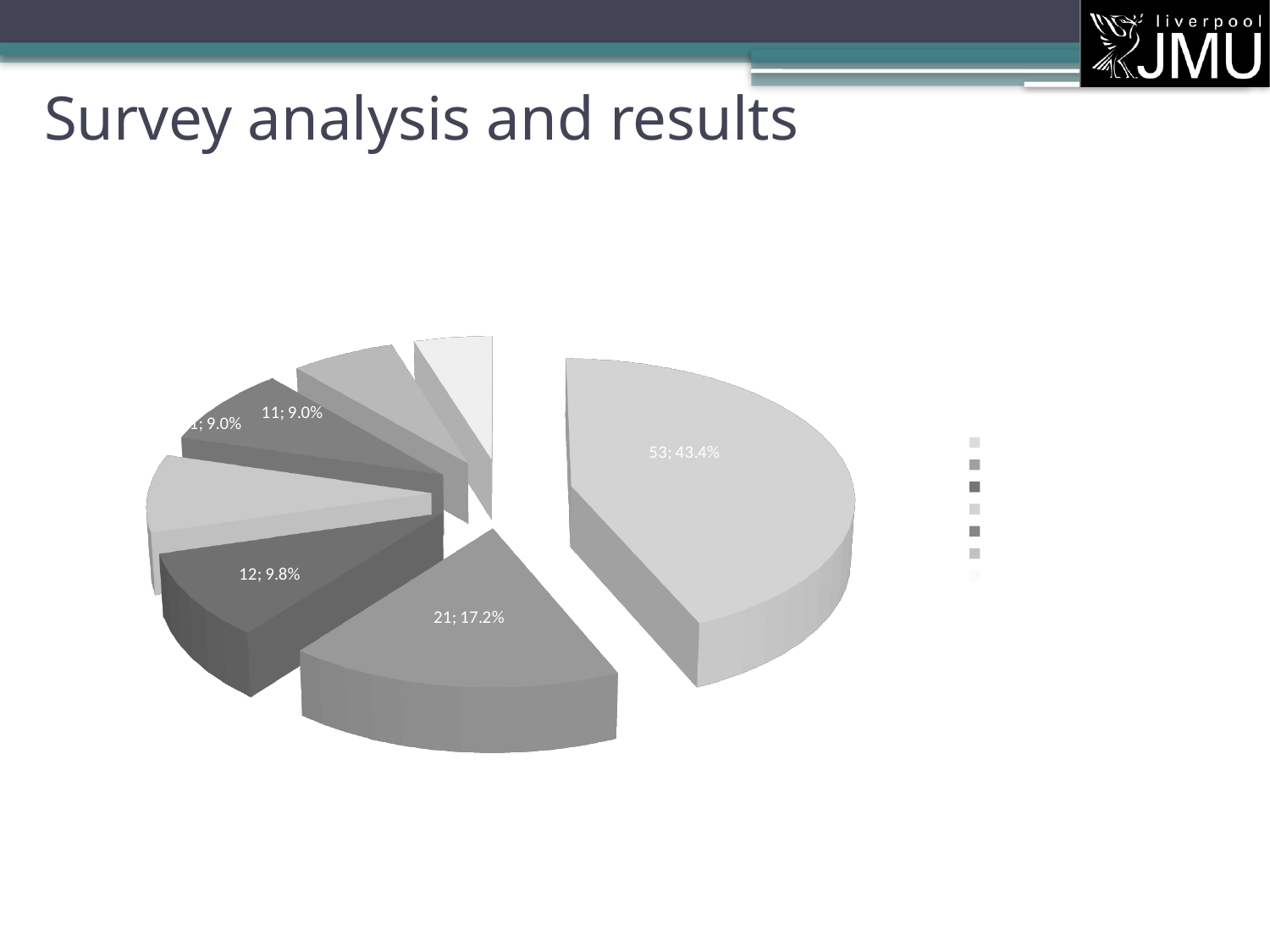
What kind of chart is shown on the slide? pie chart How many slices does the pie chart have? 7 What percentage is shown on the slice labelled with the value 12? 9.8% What is the difference between the slice with value 12 and the slice with value 11? 1 What is the value and percentage shown on the largest slice of the pie chart? 53; 43.4% How many entries does the legend to the right of the pie chart list? 7 What is the title of the slide containing the pie chart? Survey analysis and results What percentage is shown on the slice labelled with the value 21? 17.2% What share of the pie does the largest slice represent? 43.4% What is the difference between the largest slice value (53) and the second-largest slice value (21)? 32 What is the value of the second-largest slice in the pie chart? 21 Which is larger: the slice with value 21 or the slice with value 12? 21